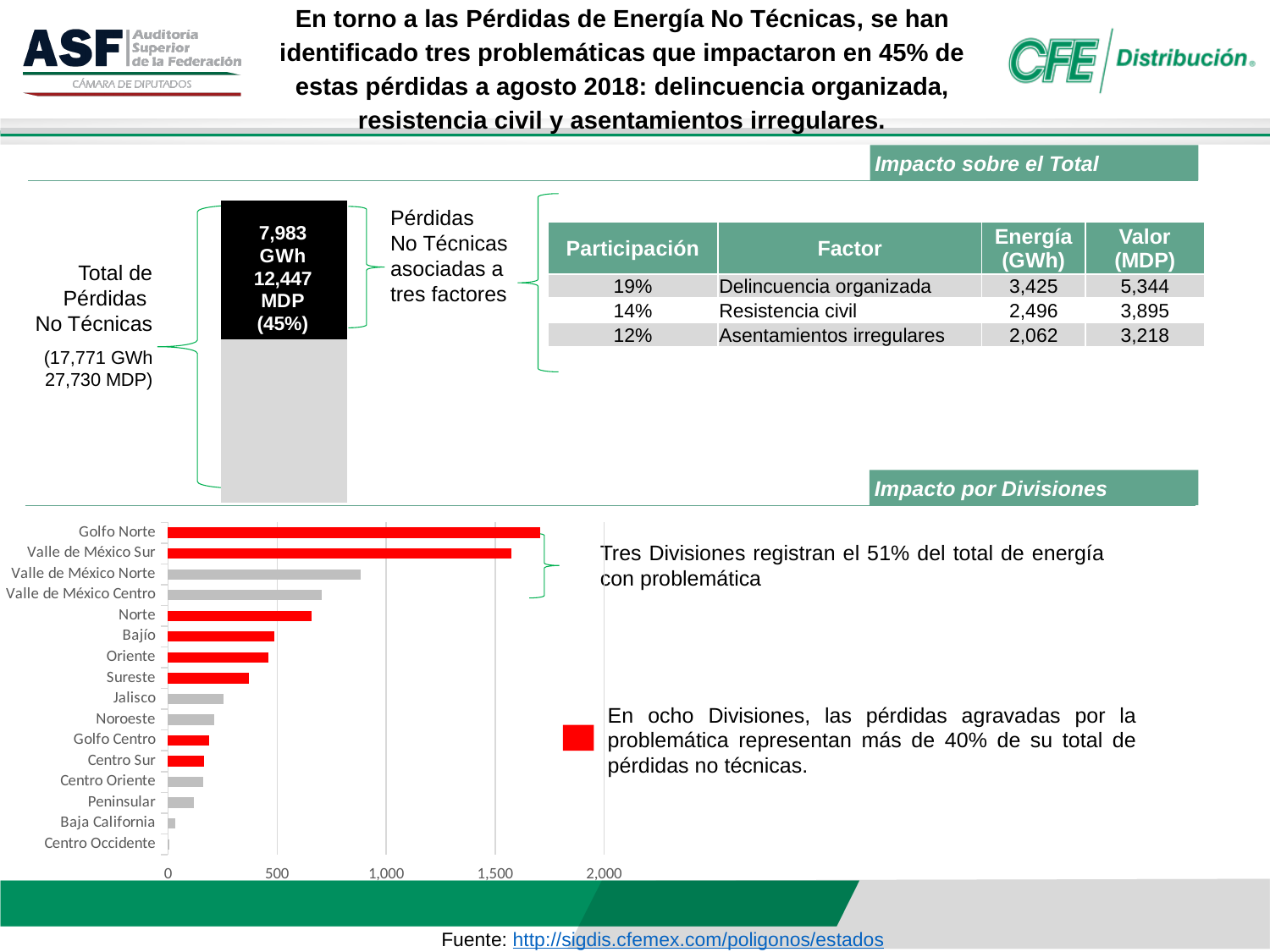
In the bar chart at the bottom left, is the value for Valle de México Norte greater or less than 1,000? less In the bar chart at the bottom left, which division has the longest bar? Golfo Norte What kind of chart is shown at the bottom left of the slide under 'Impacto por Divisiones'? bar chart In the bar chart at the bottom left, do the bar values rise or fall going from the top division to the bottom division? fall In the bar chart at the bottom left, is the value for Golfo Norte greater or less than 1,500? greater In the bar chart at the bottom left, is the value for Norte greater or less than 500? greater In the stacked bar at the top left of the slide, what energy value is printed on the black segment? 7,983 GWh In the bar chart at the bottom left, which division has the shortest bar? Centro Occidente In the bar chart at the bottom left, which has the larger value, Valle de México Sur or Valle de México Centro? Valle de México Sur In the bar chart at the bottom left, how many bars are coloured red? 8 In the bar chart at the bottom left, how many divisions are listed on the vertical axis? 16